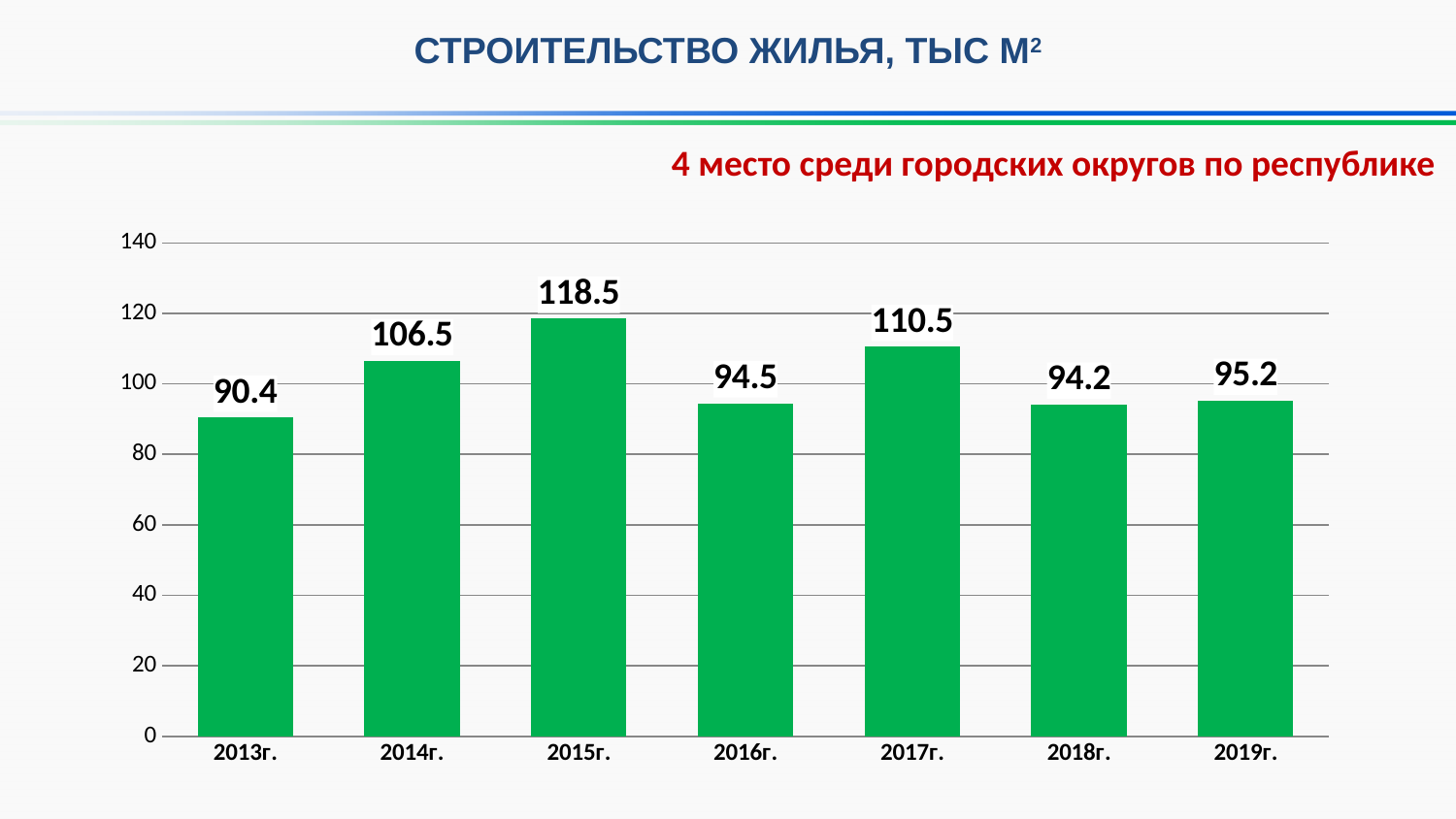
What is the difference between the values for 2017г. and 2016г.? 16 What kind of chart is shown on the slide? bar chart How many years are shown on the x axis? 7 Which is larger, the value for 2014г. or the value for 2017г.? 2017г. What is the value for 2015г.? 118.5 What is the title of the chart? СТРОИТЕЛЬСТВО ЖИЛЬЯ, ТЫС М² Which year has the lowest value? 2013г. What is the difference between the values for 2015г. and 2014г.? 12 Is the value for 2016г. greater or less than 100? less What is the value for 2013г.? 90.4 Which year has the highest value? 2015г. What is the value for 2018г.? 94.2